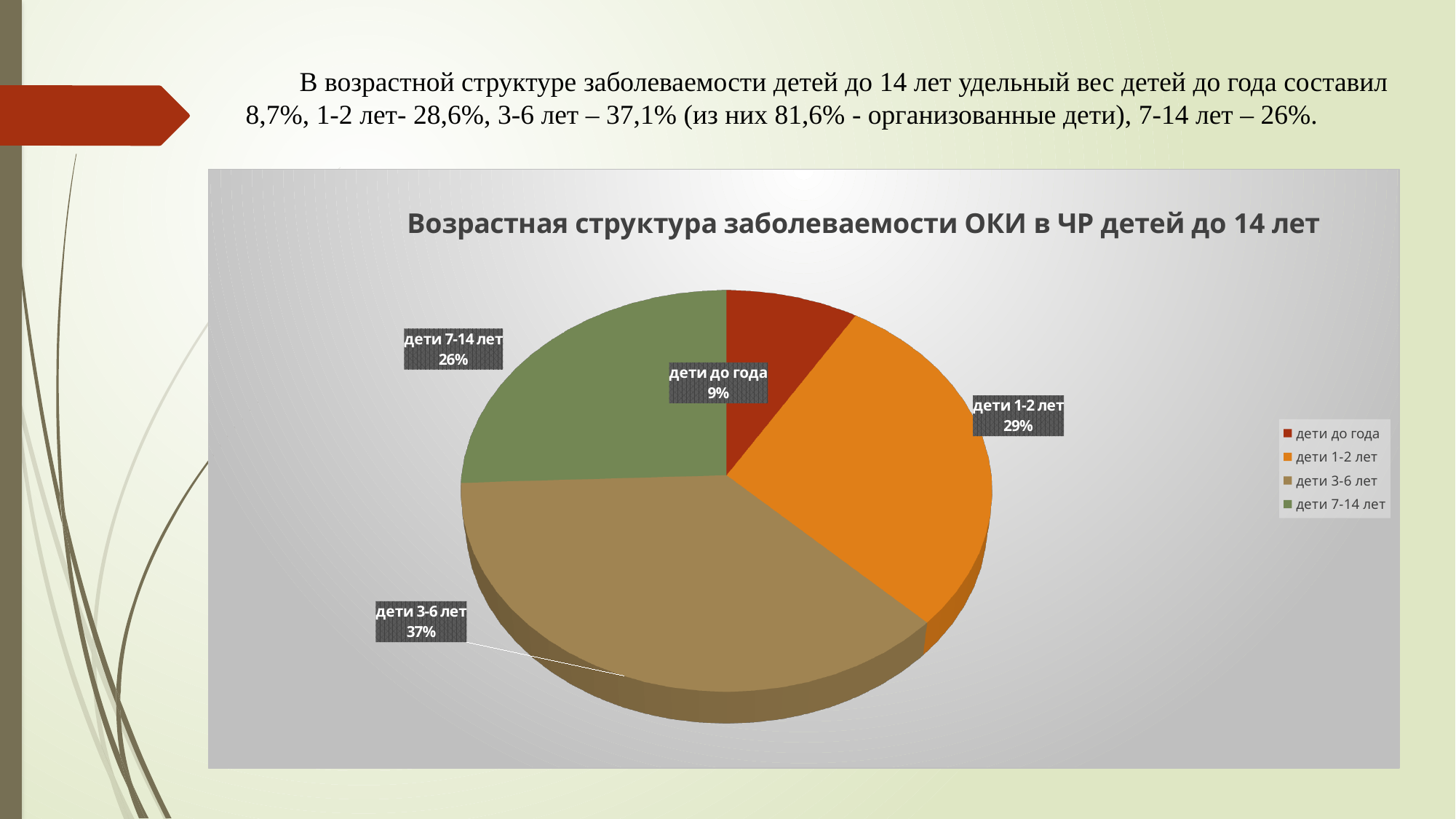
What share of the pie does the slice 'дети 7-14 лет' represent? 26% How many entries does the legend list? 4 What type of chart is shown on the slide? Pie chart Which age group has the smallest slice of the pie? дети до года What share of the pie does the slice 'дети 3-6 лет' represent? 37% What is the title of the chart? Возрастная структура заболеваемости ОКИ в ЧР детей до 14 лет What share of the pie does the slice 'дети 1-2 лет' represent? 29% Which age group has the largest slice of the pie? дети 3-6 лет What is the difference in percentage points between the 'дети 3-6 лет' slice and the 'дети до года' slice? 28% Which slice is larger: 'дети 1-2 лет' or 'дети 7-14 лет'? дети 1-2 лет How many slices does the pie chart have? 4